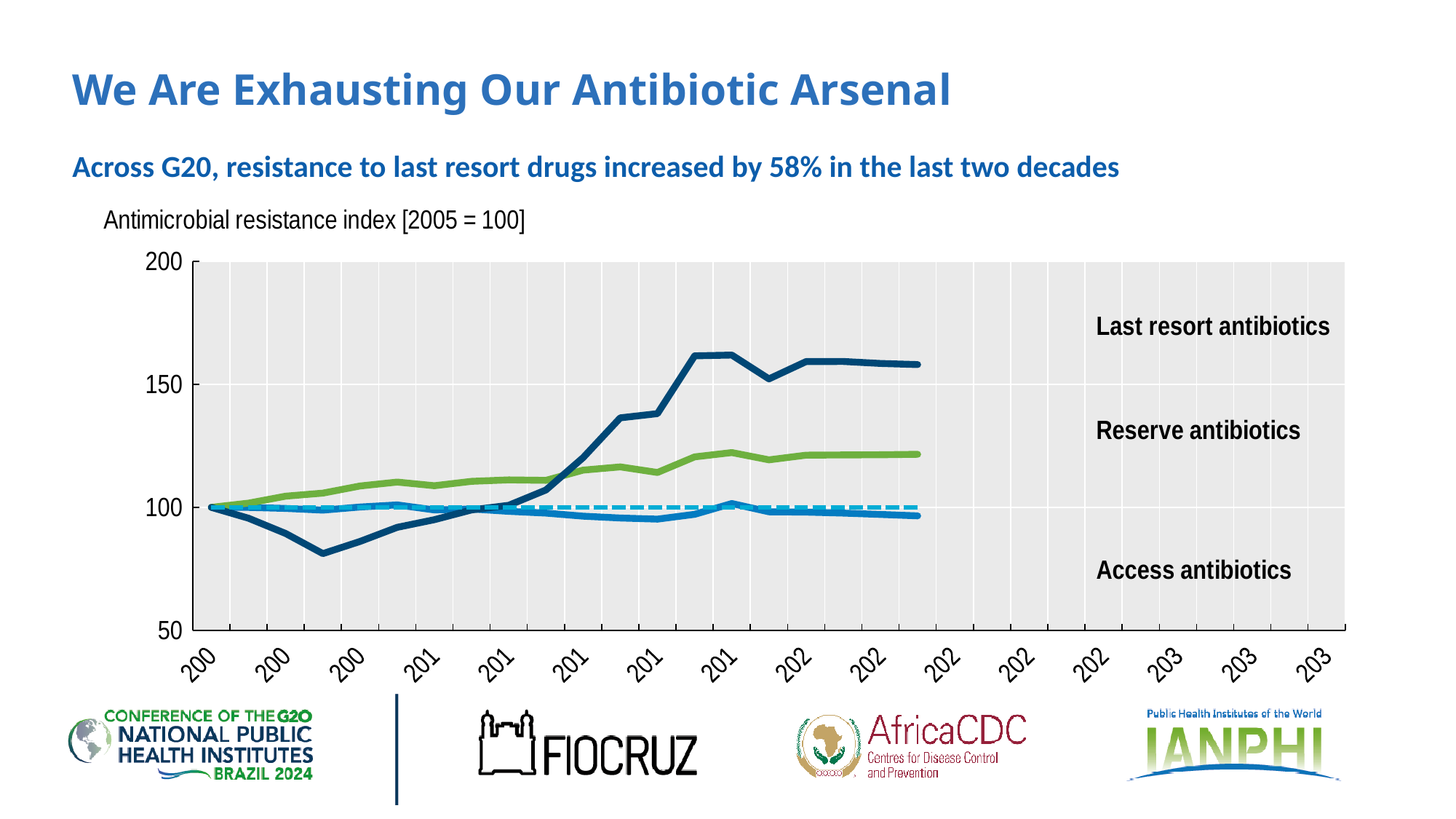
What kind of chart is shown on the slide? line chart Is the final value for Reserve antibiotics greater or less than 150? less Is the final value for Reserve antibiotics greater or less than 100? greater At the right end of the chart, which is larger: the index for Last resort antibiotics or for Reserve antibiotics? Last resort antibiotics Which antibiotic category has the lowest resistance index at the right end of the chart? Access antibiotics How many antibiotic categories are labelled on the chart? 3 Which antibiotic category has the highest resistance index at the right end of the chart? Last resort antibiotics Does the Last resort antibiotics line overall rise or fall from left to right? rise Is the lowest point of the Last resort antibiotics line greater or less than 100? less According to the chart's axis label, which year is set equal to 100 in the antimicrobial resistance index? 2005 What is the highest value shown on the y axis? 200